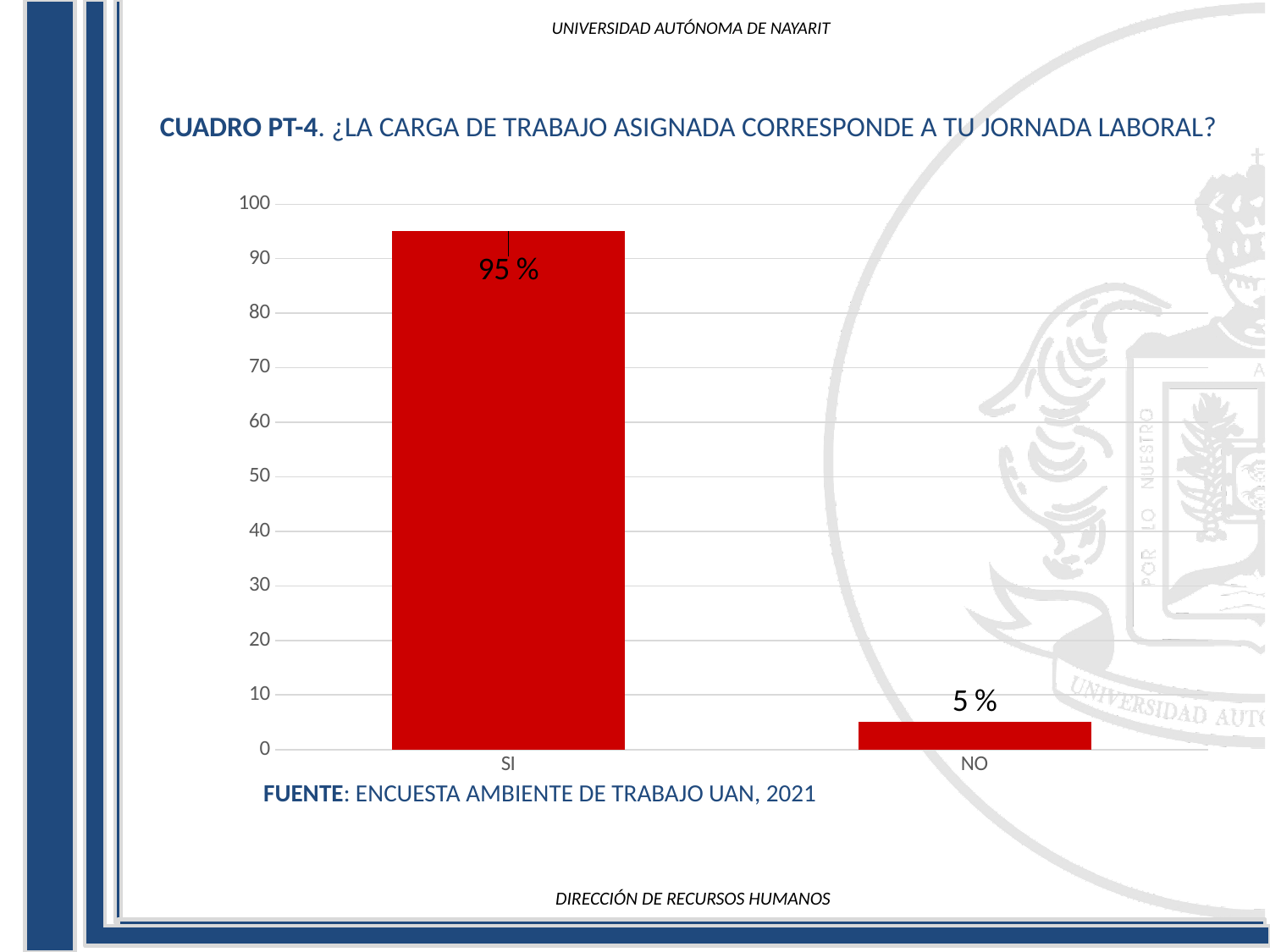
Which category has the highest value? SI What source is cited below the chart? ENCUESTA AMBIENTE DE TRABAJO UAN, 2021 What is the total of the values for SI and NO? 100 % What is the value for SI? 95 % What is the value for NO? 5 % Which is larger, the value for SI or the value for NO? SI What is the difference between the values for SI and NO? 90 % How many categories are shown on the x axis? 2 Is the value for NO greater or less than 10? less Which category has the lowest value? NO What kind of chart is shown on the slide? bar chart Is the value for SI greater or less than 90? greater